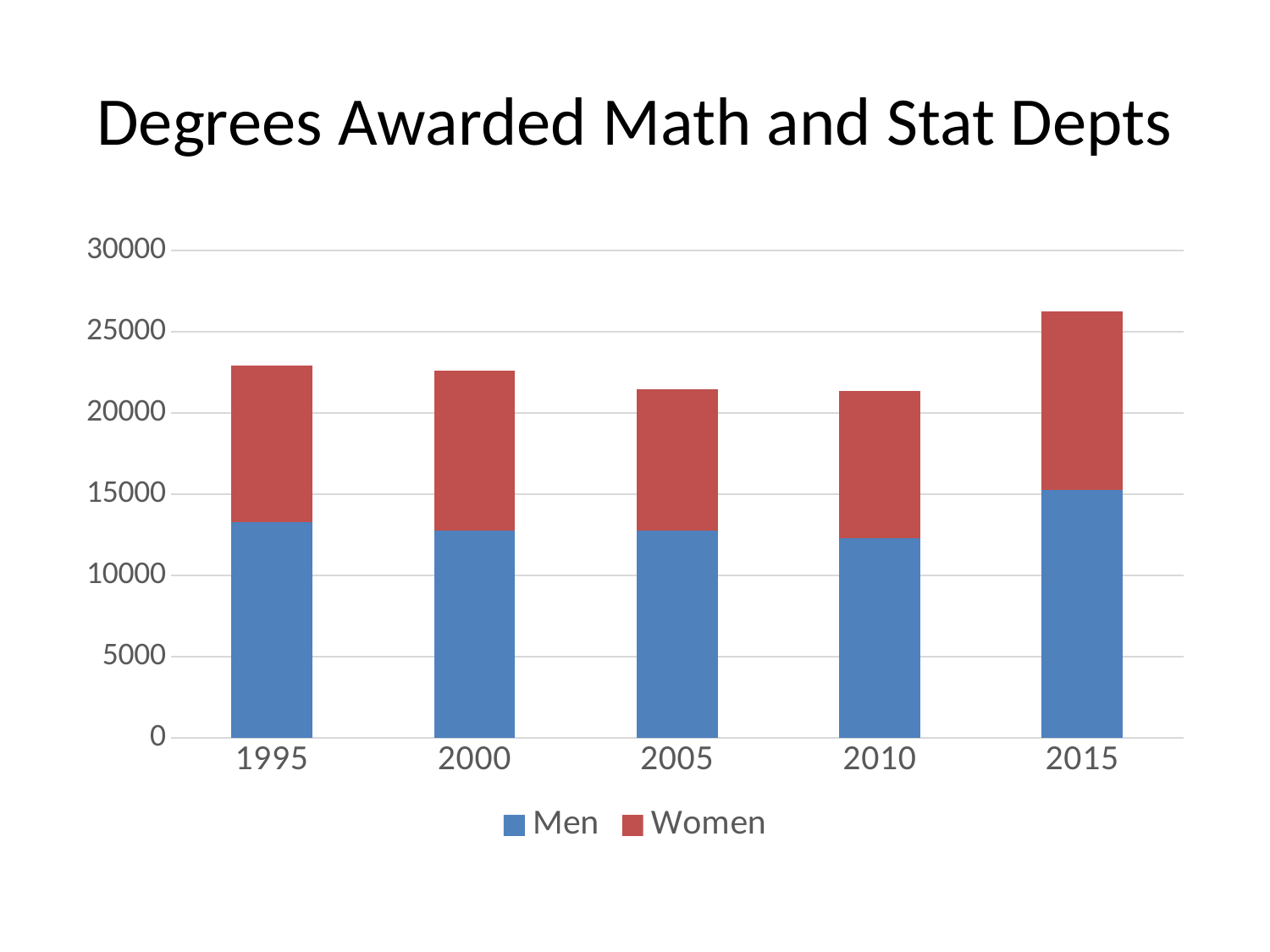
Is the total number of degrees awarded in 2015 greater or less than 25000? greater How many series does the legend list? 2 How many years are shown on the x axis? 5 Is the total number of degrees awarded in 1995 greater or less than 25000? less Is the value for Men in 2010 greater or less than 15000? less Which year has the highest total number of degrees awarded? 2015 From 1995 to 2010, do the total bar heights rise or fall? fall In which year is the Men segment the largest? 2015 Which is larger, the total for 2015 or the total for 1995? 2015 In which year is the Women segment the largest? 2015 What kind of chart is shown on the slide? Stacked bar chart